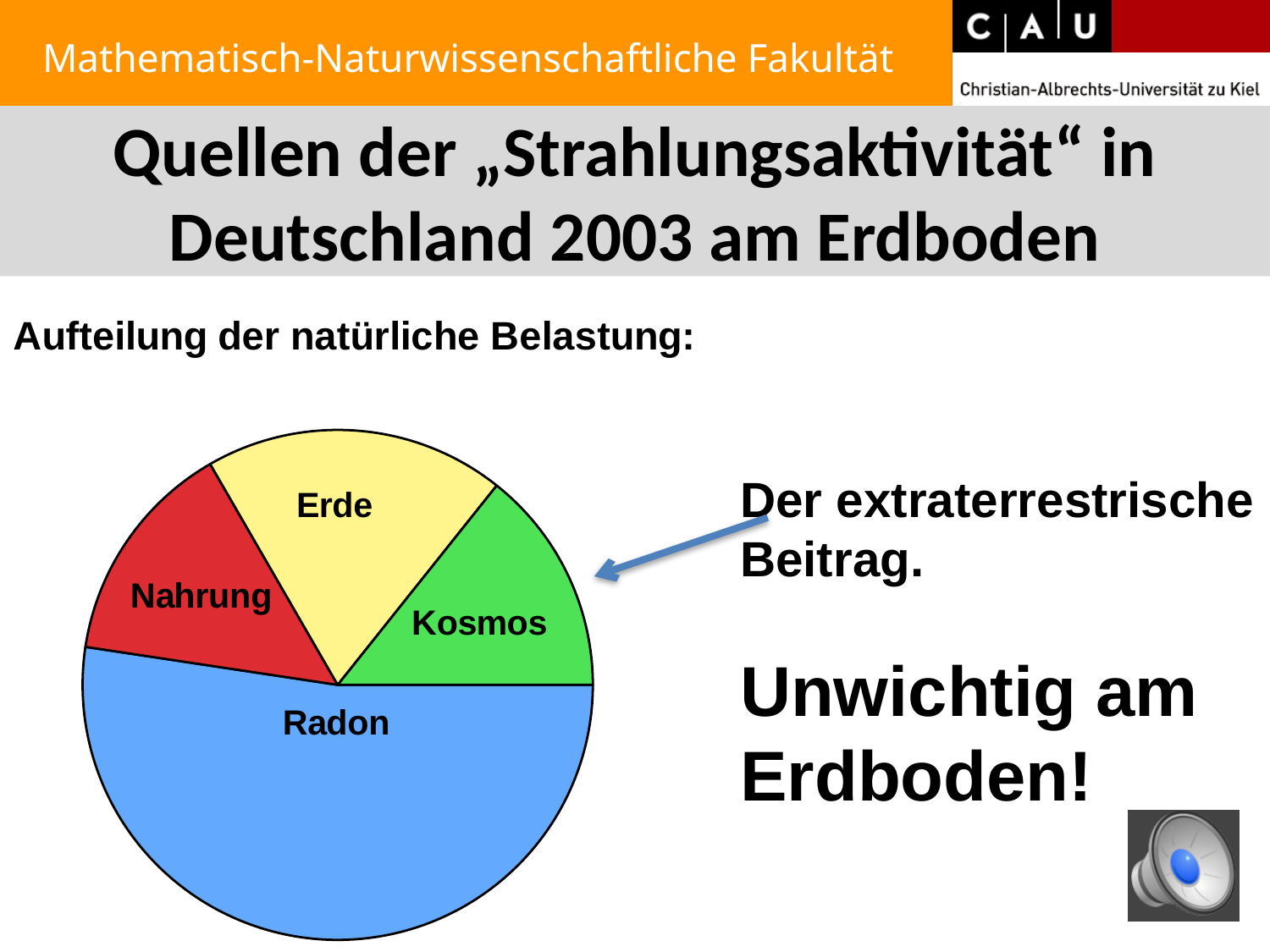
Which slice is larger, Radon or Nahrung? Radon What kind of chart is shown on the slide? pie chart Which slice is larger, Radon or Kosmos? Radon How many slices does the pie chart have? 4 Which slice is larger, Radon or Erde? Radon What colour is the Radon slice in the pie chart? blue Which slice of the pie chart is coloured green? Kosmos Does the Radon slice make up more or less than half of the pie? more Which category has the largest slice in the pie chart? Radon Which slice does the arrow labelled 'Der extraterrestrische Beitrag' point to? Kosmos